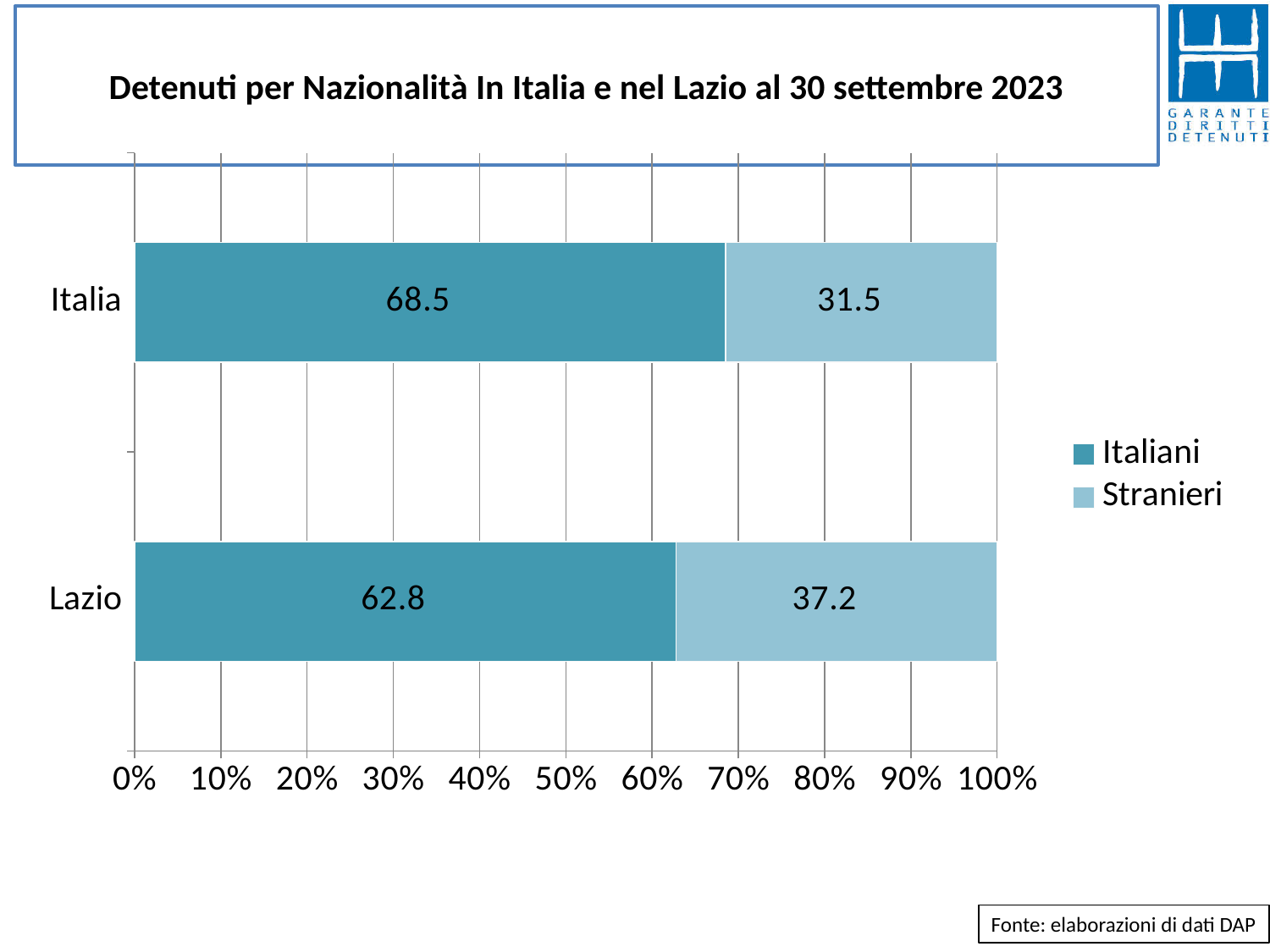
How many series does the legend list? 2 What is the value for Stranieri in Lazio? 37.2 How many categories are shown on the chart? 2 What is the difference between the Stranieri values for Lazio and Italia? 5.7 Which category has the higher Stranieri value, Italia or Lazio? Lazio What is the total of the stacked bar for Lazio? 100 What is the value for Stranieri in Italia? 31.5 What is the value for Italiani in Lazio? 62.8 What is the difference between the Italiani values for Italia and Lazio? 5.7 What kind of chart is shown on the slide? Stacked bar chart Which category has the higher Italiani value, Italia or Lazio? Italia What is the value for Italiani in Italia? 68.5